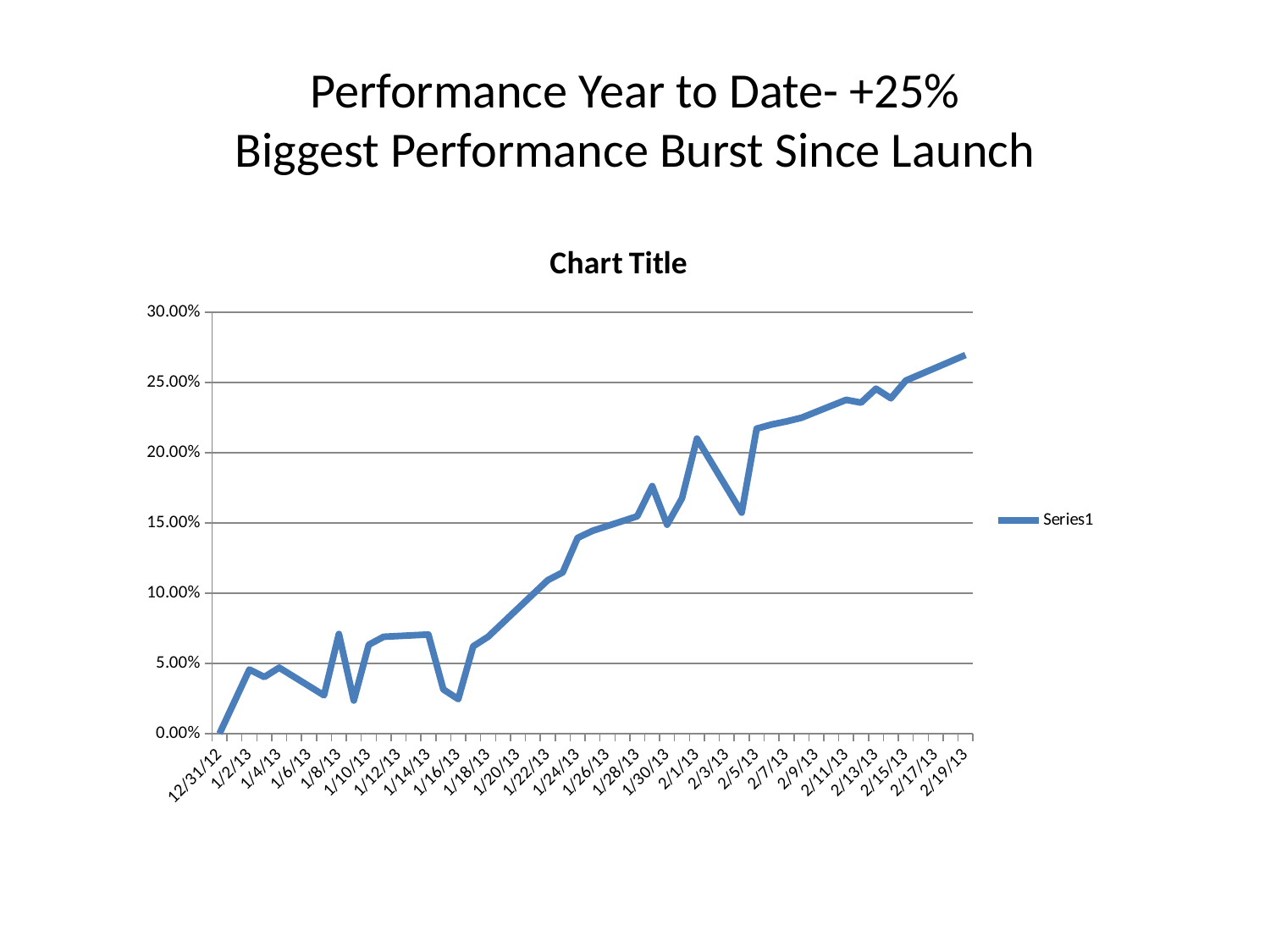
Which date has the highest value? 2/19/13 What is the name of the series shown in the legend? Series1 Which date has the lowest value? 12/31/12 Is the value for 2/1/13 greater or less than 20.00%? greater Is the value for 2/19/13 greater or less than 25.00%? greater What is the value for 12/31/12? 0.00% Do the values generally rise or fall from 12/31/12 to 2/19/13? Rise What is the title printed above the chart? Chart Title How many series does the legend list? 1 What type of chart is shown on the slide? Line chart Is the value for 1/16/13 greater or less than 5.00%? less